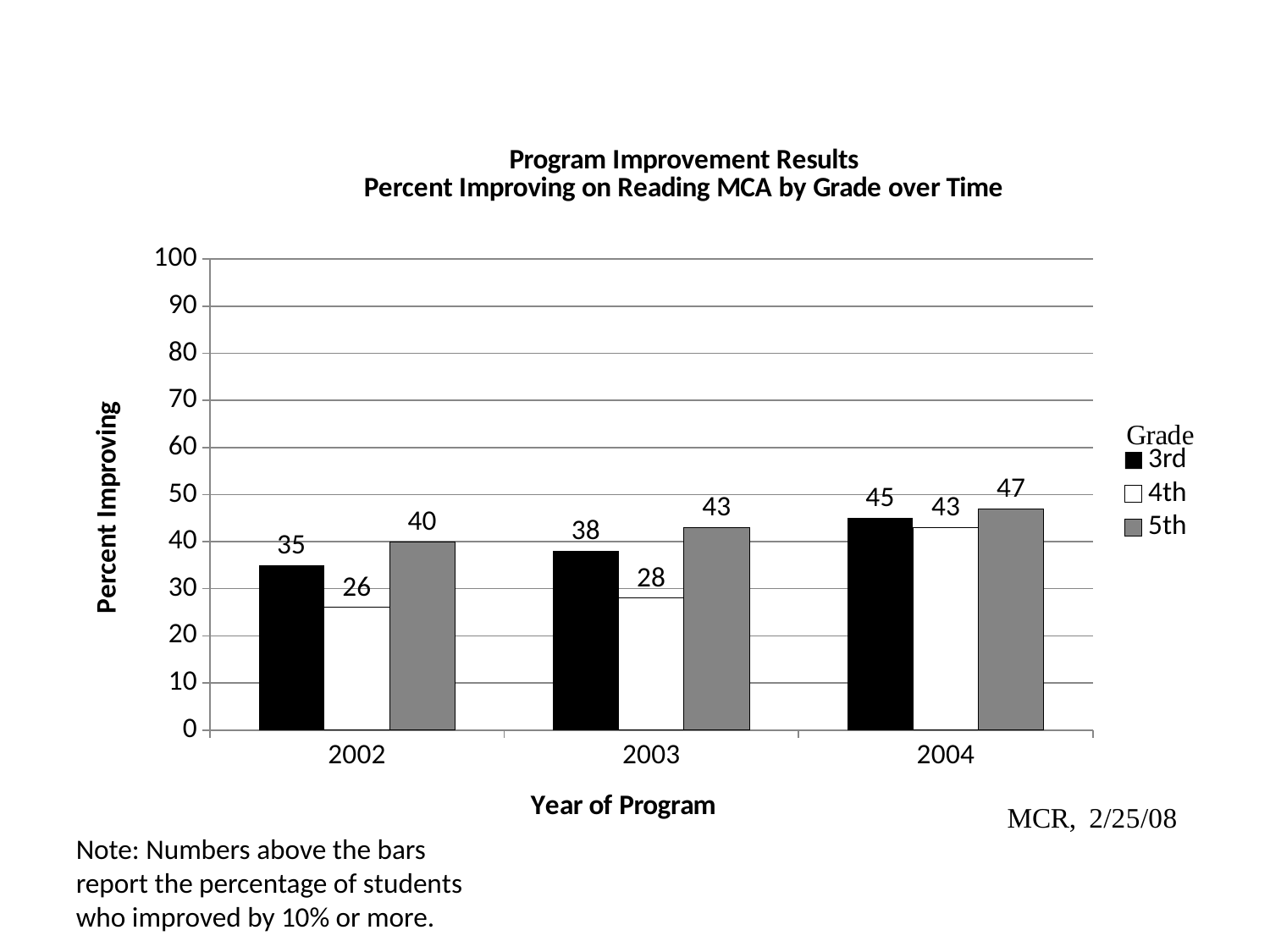
How many series does the legend list? 3 Is the value for 4th grade in 2004 greater or less than 40? greater What is the percent improving for 3rd grade in 2002? 35 What is the percent improving for 5th grade in 2004? 47 What is the difference between the 5th grade and 4th grade values in 2002? 14 Which is larger, the 3rd grade value in 2003 or the 5th grade value in 2003? 5th grade value in 2003 What is the percent improving for 4th grade in 2003? 28 Which grade has the lowest percent improving in 2002? 4th How many years are shown on the x axis? 3 What kind of chart is shown on the slide? bar chart Which grade has the highest percent improving in 2004? 5th Do the 3rd grade values rise or fall from 2002 to 2004? rise